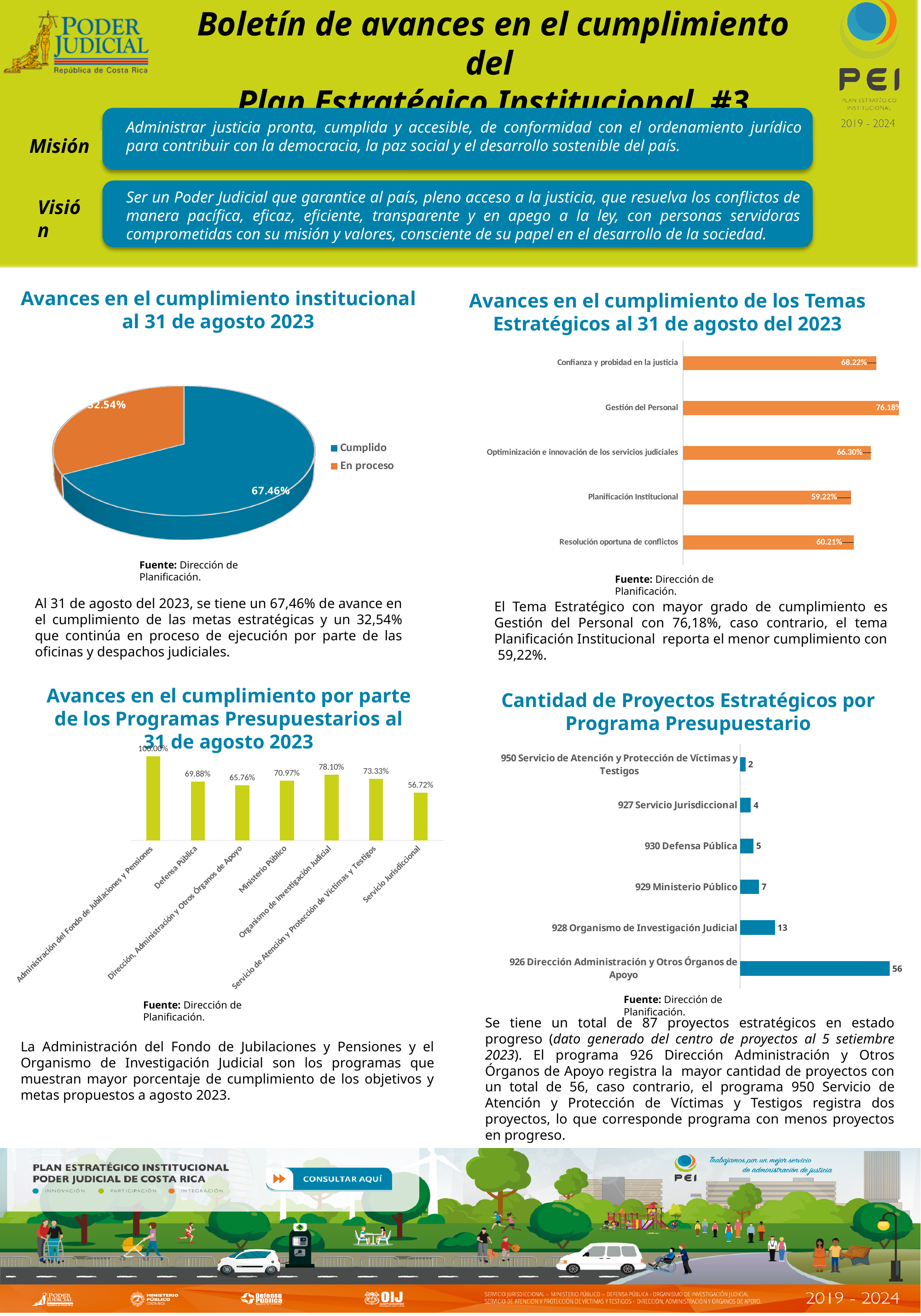
In the chart 'Avances en el cumplimiento por parte de los Programas Presupuestarios al 31 de agosto 2023', what is the value for Organismo de Investigación Judicial? 78.10% In the chart 'Avances en el cumplimiento por parte de los Programas Presupuestarios al 31 de agosto 2023', which is larger: Defensa Pública or Ministerio Público? Ministerio Público In the chart 'Avances en el cumplimiento por parte de los Programas Presupuestarios al 31 de agosto 2023', which programa has the lowest value? Servicio Jurisdiccional In the pie chart 'Avances en el cumplimiento institucional al 31 de agosto 2023', what share is labelled 'Cumplido'? 67.46% In the chart 'Avances en el cumplimiento de los Temas Estratégicos al 31 de agosto del 2023', what is the value for Gestión del Personal? 76.18% In the chart 'Cantidad de Proyectos Estratégicos por Programa Presupuestario', what is the difference between 926 Dirección Administración y Otros Órganos de Apoyo and 929 Ministerio Público? 49 In the chart 'Avances en el cumplimiento de los Temas Estratégicos al 31 de agosto del 2023', which tema has the lowest value? Planificación Institucional In the chart 'Avances en el cumplimiento de los Temas Estratégicos al 31 de agosto del 2023', what is the difference between Confianza y probidad en la justicia and Resolución oportuna de conflictos? 8.01% What kind of chart is 'Cantidad de Proyectos Estratégicos por Programa Presupuestario'? Bar chart In the chart 'Cantidad de Proyectos Estratégicos por Programa Presupuestario', how many projects does 928 Organismo de Investigación Judicial have? 13 In the chart 'Avances en el cumplimiento de los Temas Estratégicos al 31 de agosto del 2023', how many temas are plotted? 5 In the pie chart 'Avances en el cumplimiento institucional al 31 de agosto 2023', how many entries does the legend list? 2